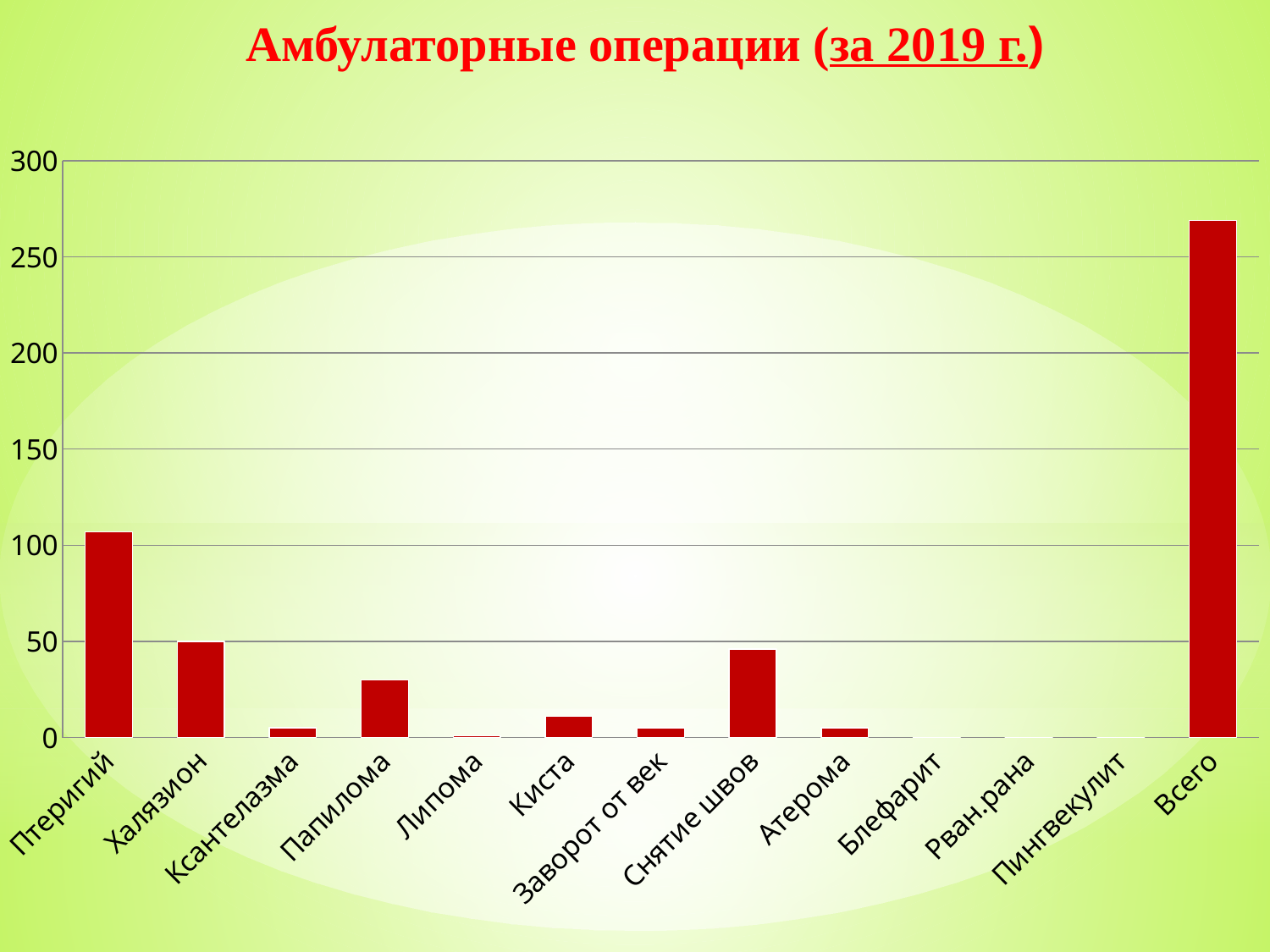
Is the value for Киста greater or less than 50? less What is the title of the slide containing the chart? Амбулаторные операции (за 2019 г.) What colour are the bars in the chart? Red Is the value for Папилома greater or less than 50? less Which is larger, the value for Птеригий or the value for Халязион? Птеригий Is the value for Всего greater or less than 250? greater Which is larger, the value for Снятие швов or the value for Папилома? Снятие швов What kind of chart is shown on the slide? Bar chart Which category has the highest bar in the chart? Всего How many categories are shown on the x axis of the chart? 13